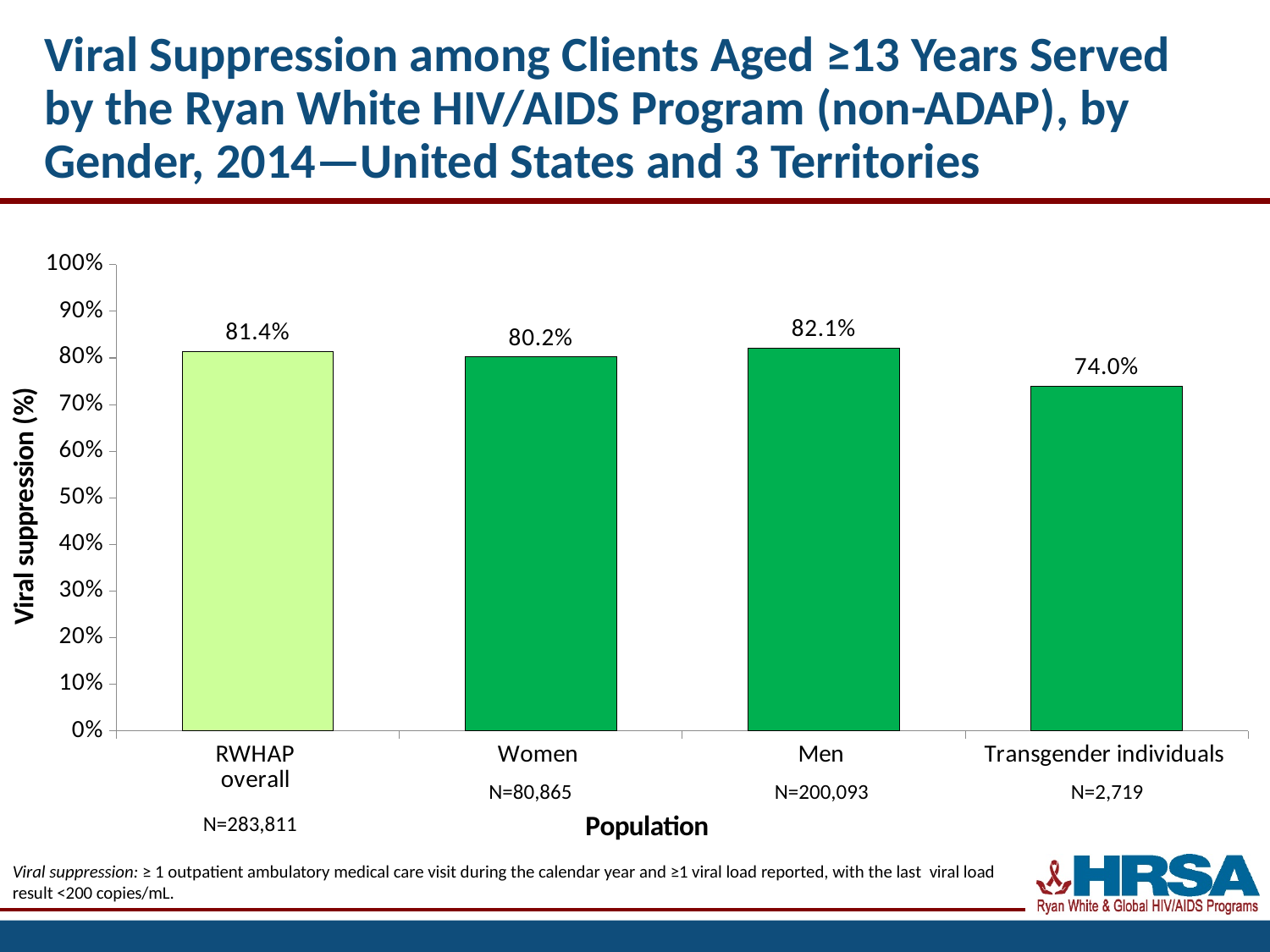
Which population has the highest viral suppression percentage? Men What is the viral suppression percentage for Women? 80.2% Which population has the lowest viral suppression percentage? Transgender individuals How many population categories are shown on the chart? 4 What is the difference in viral suppression between RWHAP overall and Women? 1.2% What kind of chart is shown on the slide? Bar chart What is the label of the y axis? Viral suppression (%) What is the difference in viral suppression between Men and Transgender individuals? 8.1% What is the viral suppression percentage for Transgender individuals? 74.0% Which has a higher viral suppression percentage, Women or Transgender individuals? Women What is the viral suppression percentage for RWHAP overall? 81.4% Is the value for Men greater or less than 80%? greater